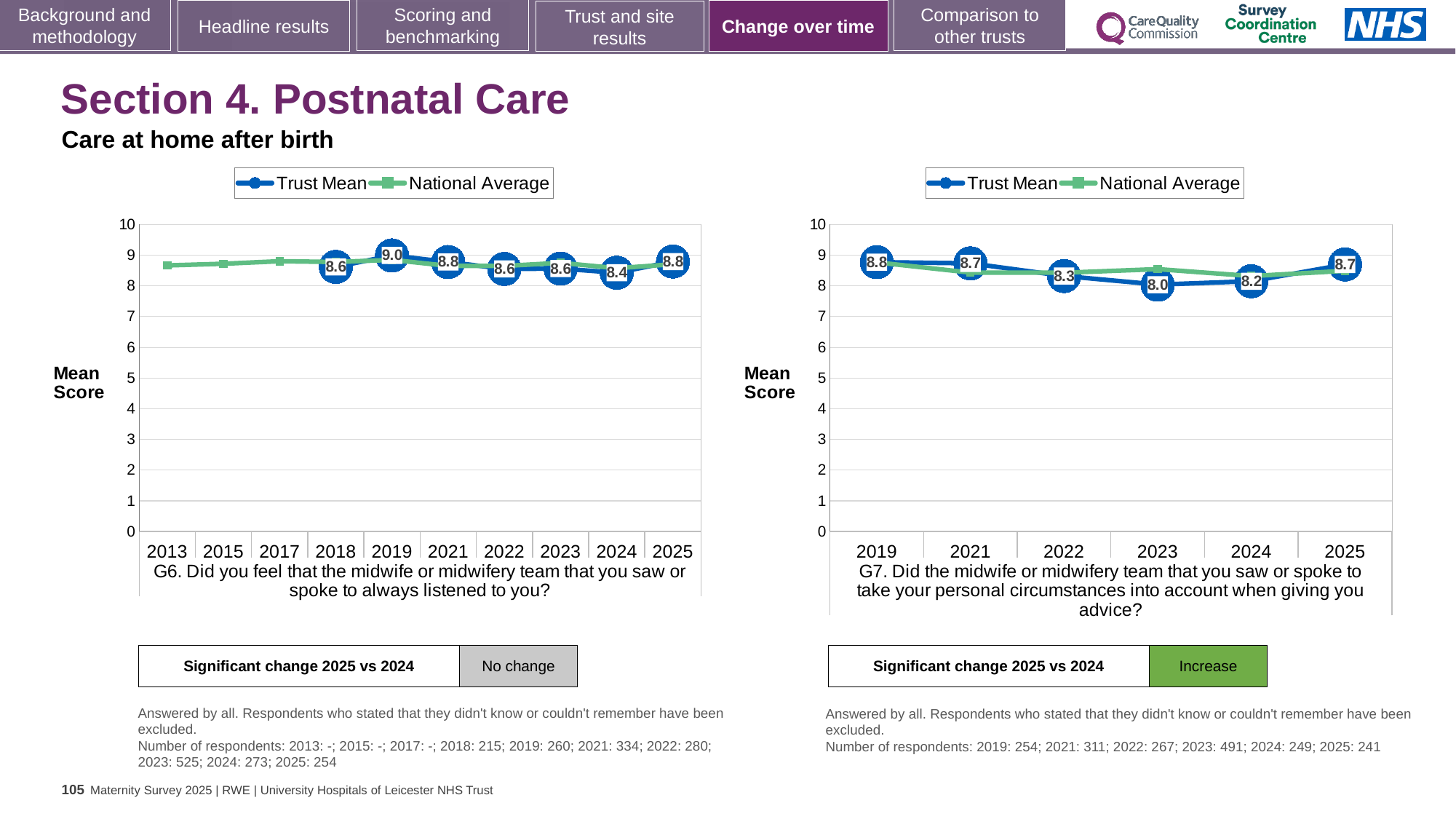
In the left chart (G6), which year has the lowest labelled Trust Mean? 2024 In the left chart (G6), which year has the highest Trust Mean? 2019 What kind of chart is the right chart (G7)? Line chart In the left chart (G6), what is the difference between the Trust Mean in 2025 and in 2024? 0.4 In the right chart (G7), which year has the highest Trust Mean? 2019 In the right chart (G7), what is the Trust Mean for 2023? 8.0 In the left chart (G6), what is the Trust Mean for 2019? 9.0 In the right chart (G7), which year has the lowest Trust Mean? 2023 In the left chart (G6), what is the Trust Mean for 2024? 8.4 In the right chart (G7), what is the Trust Mean for 2025? 8.7 In the right chart (G7), how many years are shown on the x axis? 6 How many series does the legend of the left chart (G6) list? 2